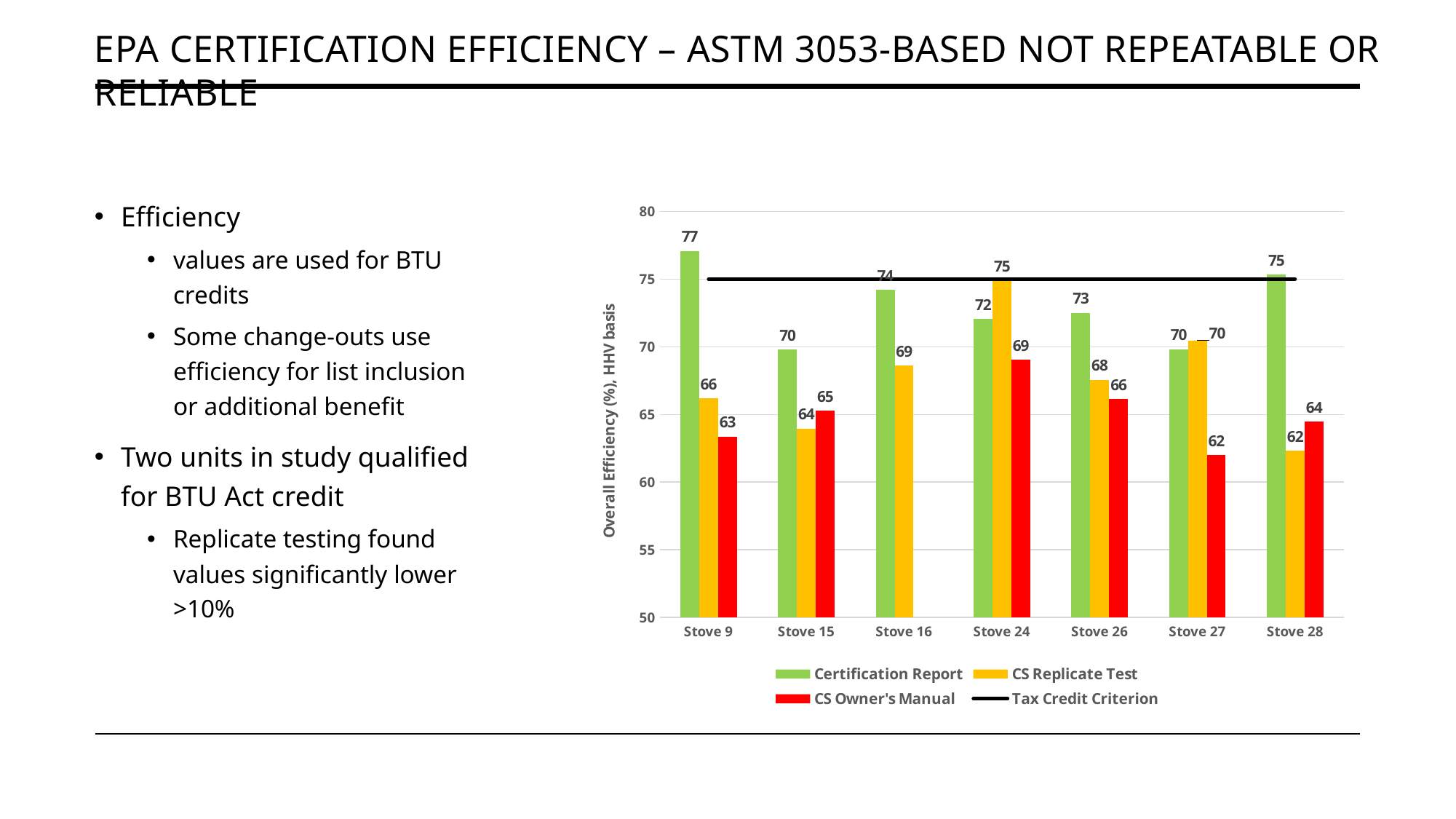
Which stove has the lowest CS Replicate Test value? Stove 28 Which stove has the highest Certification Report value? Stove 9 For Stove 9, what is the difference between the Certification Report value and the CS Owner's Manual value? 14 Is the Certification Report value for Stove 15 greater or less than 75? less What is the CS Owner's Manual value for Stove 27? 62 How many stoves are shown on the x axis? 7 What kind of chart is shown on the slide? combination bar and line chart For Stove 24, which is larger: the Certification Report value or the CS Replicate Test value? CS Replicate Test How many entries does the legend list? 4 What is the title of the vertical axis? Overall Efficiency (%), HHV basis What is the CS Replicate Test value for Stove 16? 69 What is the Certification Report value for Stove 9? 77